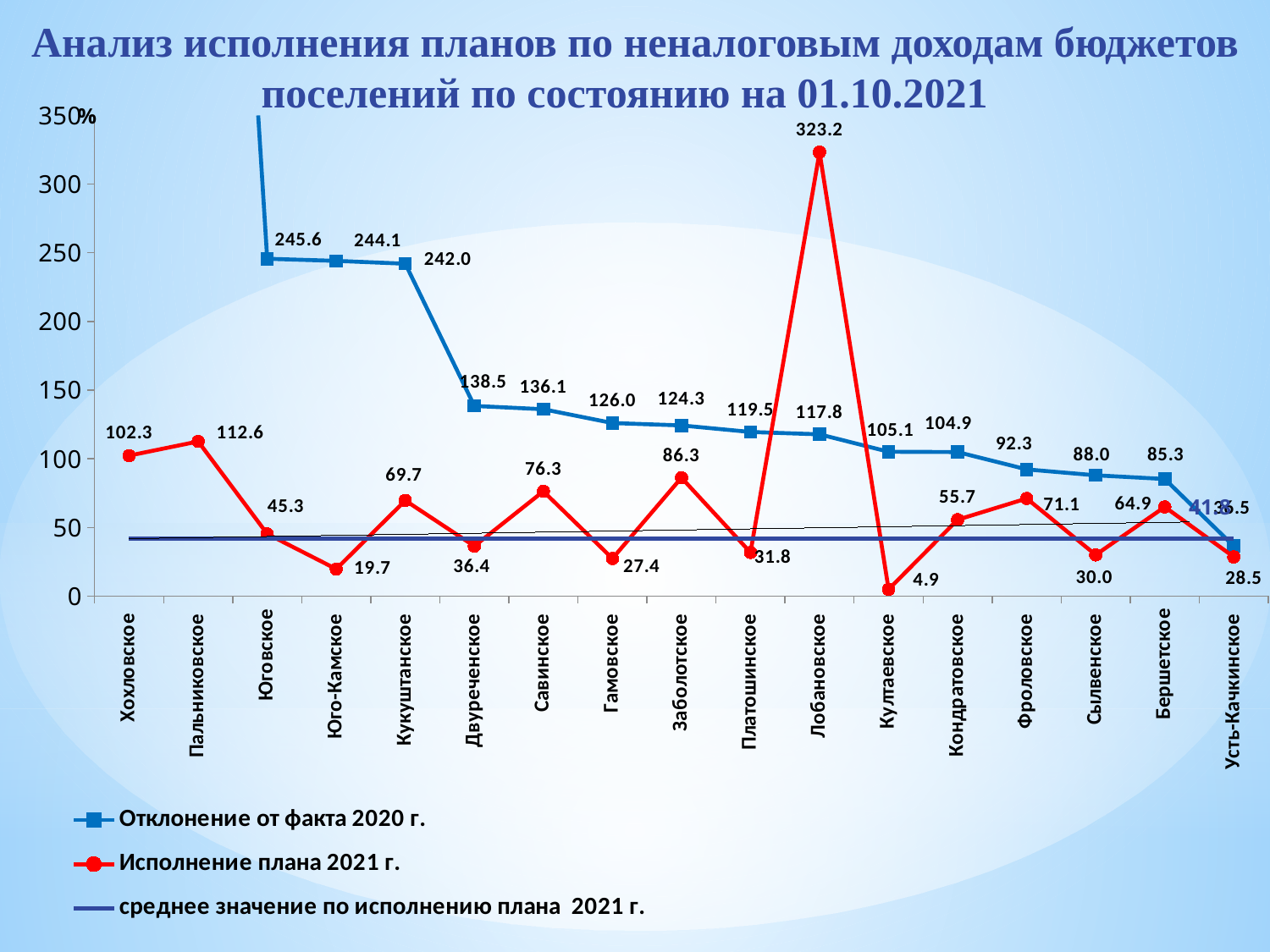
How many series does the legend list? 3 What kind of chart is shown on the slide? line chart What is the value of 'Исполнение плана 2021 г.' for Култаевское? 4.9 Which settlement has the highest value for 'Исполнение плана 2021 г.'? Лобановское What is the difference between the 'Исполнение плана 2021 г.' values for Пальниковское and Хохловское? 10.3 Which has the larger 'Исполнение плана 2021 г.' value, Савинское or Заболотское? Заболотское What is the title of the chart? Анализ исполнения планов по неналоговым доходам бюджетов поселений по состоянию на 01.10.2021 Does the 'Отклонение от факта 2020 г.' series generally rise or fall from left to right along the x axis? fall What is the value of 'Отклонение от факта 2020 г.' for Юговское? 245.6 What is the value of 'Исполнение плана 2021 г.' for Лобановское? 323.2 How many settlements (categories) are plotted along the x axis? 17 Which settlement has the lowest value for 'Исполнение плана 2021 г.'? Култаевское